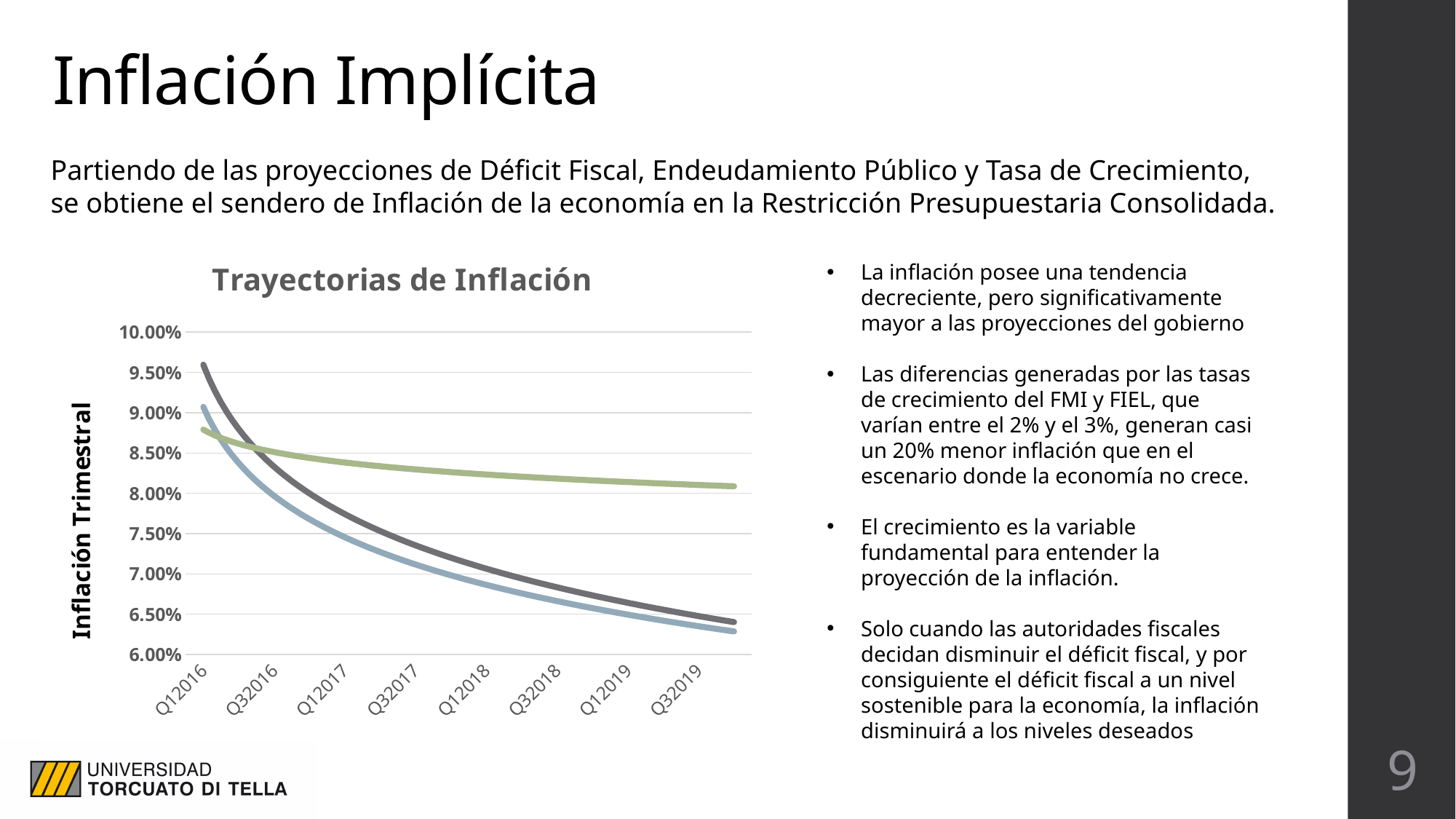
Which line is highest at the end of the chart (around Q32019)? the green line What is the title of the chart on the slide? Trayectorias de Inflación How many category labels are shown on the x axis of the chart? 8 Is the value of the dark gray line at Q12016 greater or less than 9.00%? greater Which line is lowest at the end of the chart (around Q32019)? the blue line Is the value of the green line at Q12016 greater or less than 9.00%? less Is the value of the green line at the end of the chart greater or less than 8.00%? greater At Q32019, which is larger: the value of the green line or the value of the blue line? the green line What kind of chart is 'Trayectorias de Inflación'? line chart Which line is highest at Q12016? the dark gray line What is the label of the vertical axis of the chart? Inflación Trimestral Do the lines in the chart rise or fall from Q12016 to Q32019? fall